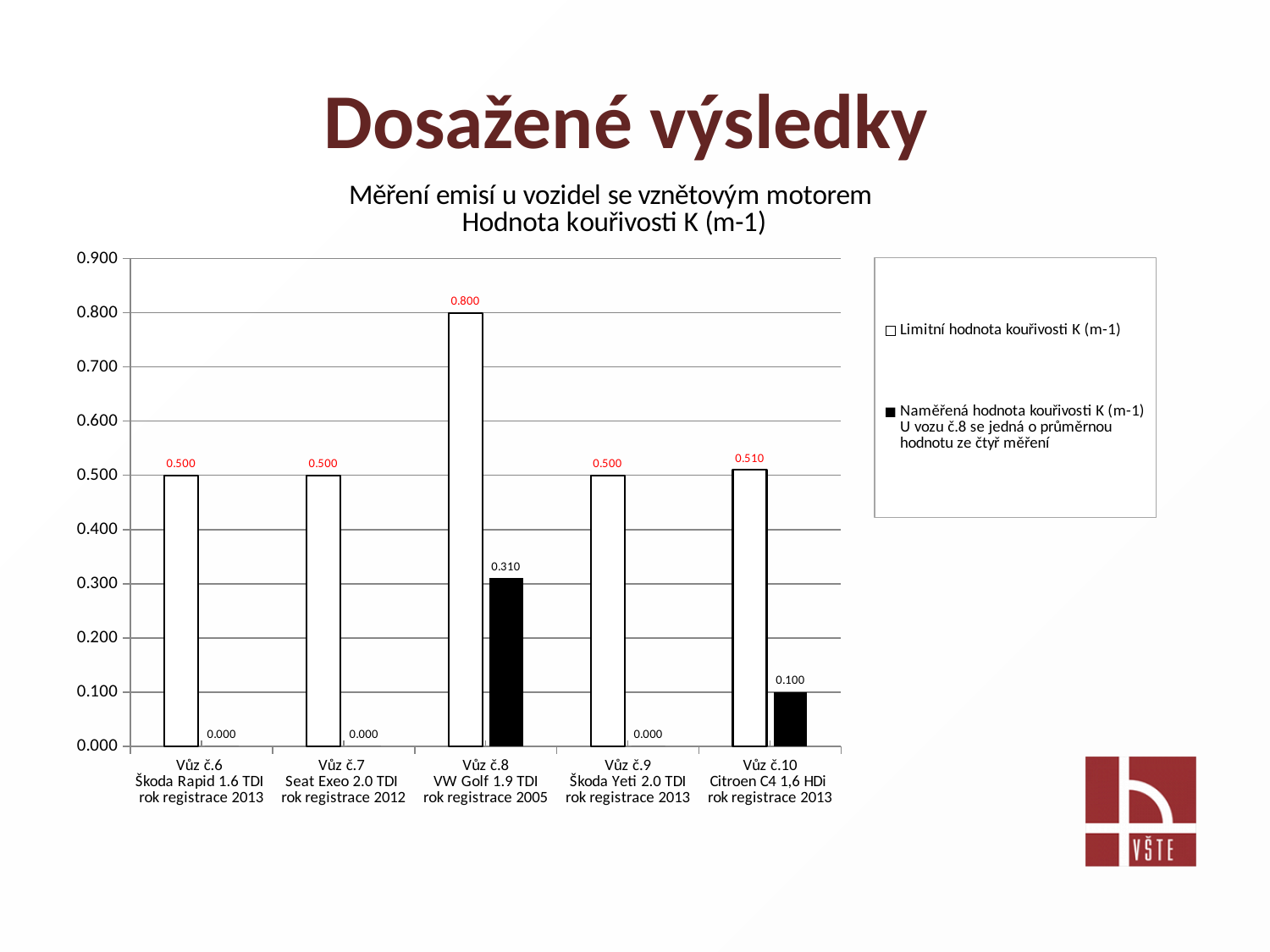
What is the limit value (Limitní hodnota kouřivosti) for Vůz č.10? 0.510 What is the measured value (Naměřená hodnota kouřivosti) for Vůz č.8? 0.310 What is the limit value (Limitní hodnota kouřivosti) for Vůz č.8? 0.800 What is the difference between the limit value and the measured value for Vůz č.8? 0.490 How many vehicles (categories) are shown on the x axis? 5 How many vehicles have a measured value of 0.000? 3 Which vehicle has the highest measured value (Naměřená hodnota kouřivosti)? Vůz č.8 Is the measured value for Vůz č.10 larger or smaller than the measured value for Vůz č.8? smaller What is the measured value (Naměřená hodnota kouřivosti) for Vůz č.10? 0.100 How many series does the legend list? 2 Which vehicle has the highest limit value (Limitní hodnota kouřivosti)? Vůz č.8 What kind of chart is shown on the slide? bar chart